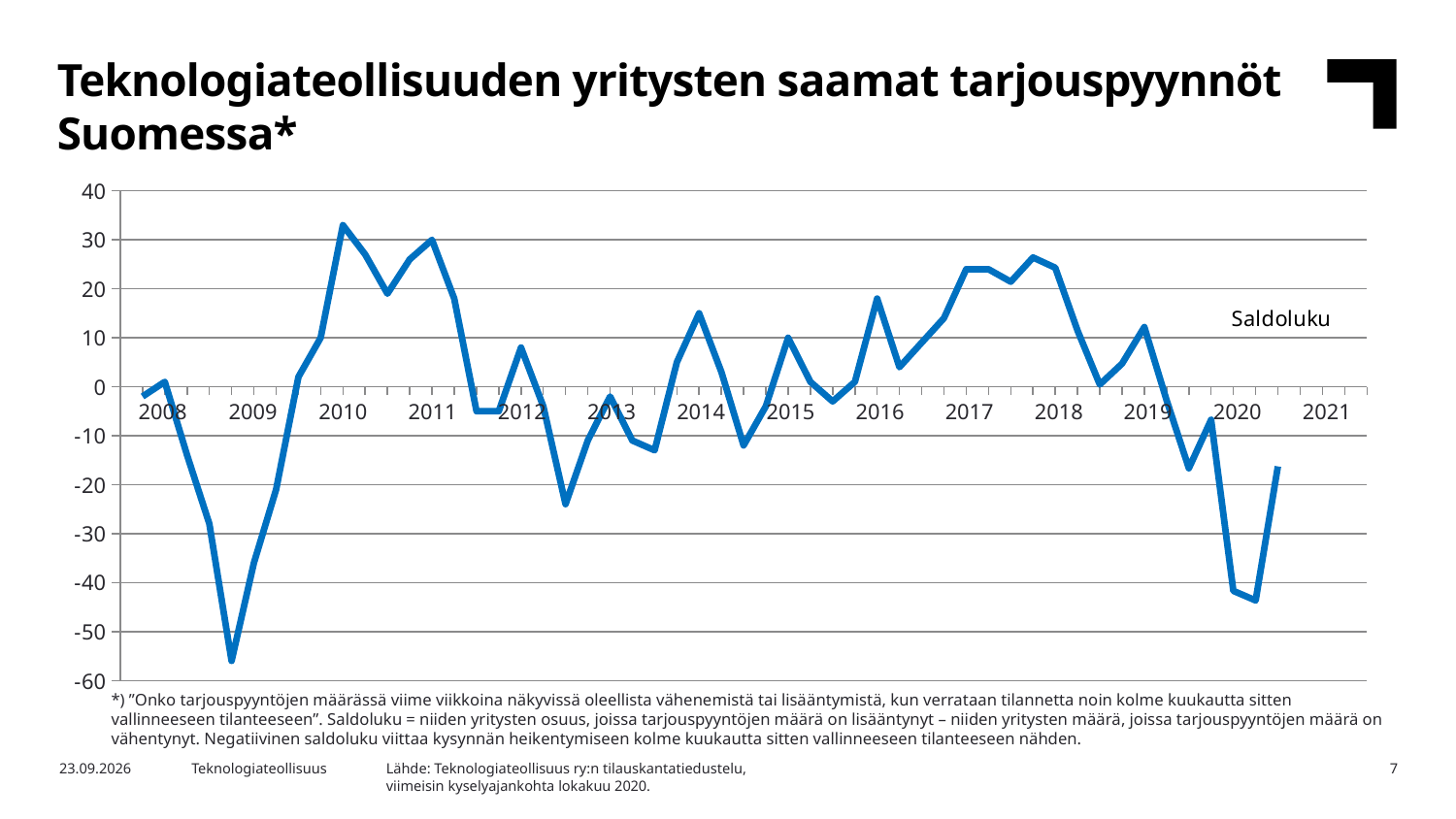
Does the line rise or fall between 2018 and 2020? fall Is the peak value of the line in 2018 greater or less than 20? greater What kind of chart is shown on the slide? line chart Does the line rise or fall between 2009 and 2010? rise In which year does the line reach its highest point? 2010 In which year does the line reach its lowest point? 2009 Is the peak value of the line in 2010 greater or less than 30? greater Is the lowest value of the line in 2009 greater or less than -50? less What is the title of the chart on the slide? Teknologiateollisuuden yritysten saamat tarjouspyynnöt Suomessa* What is the name of the series plotted in the chart? Saldoluku How many year labels are shown on the x axis of the chart? 14